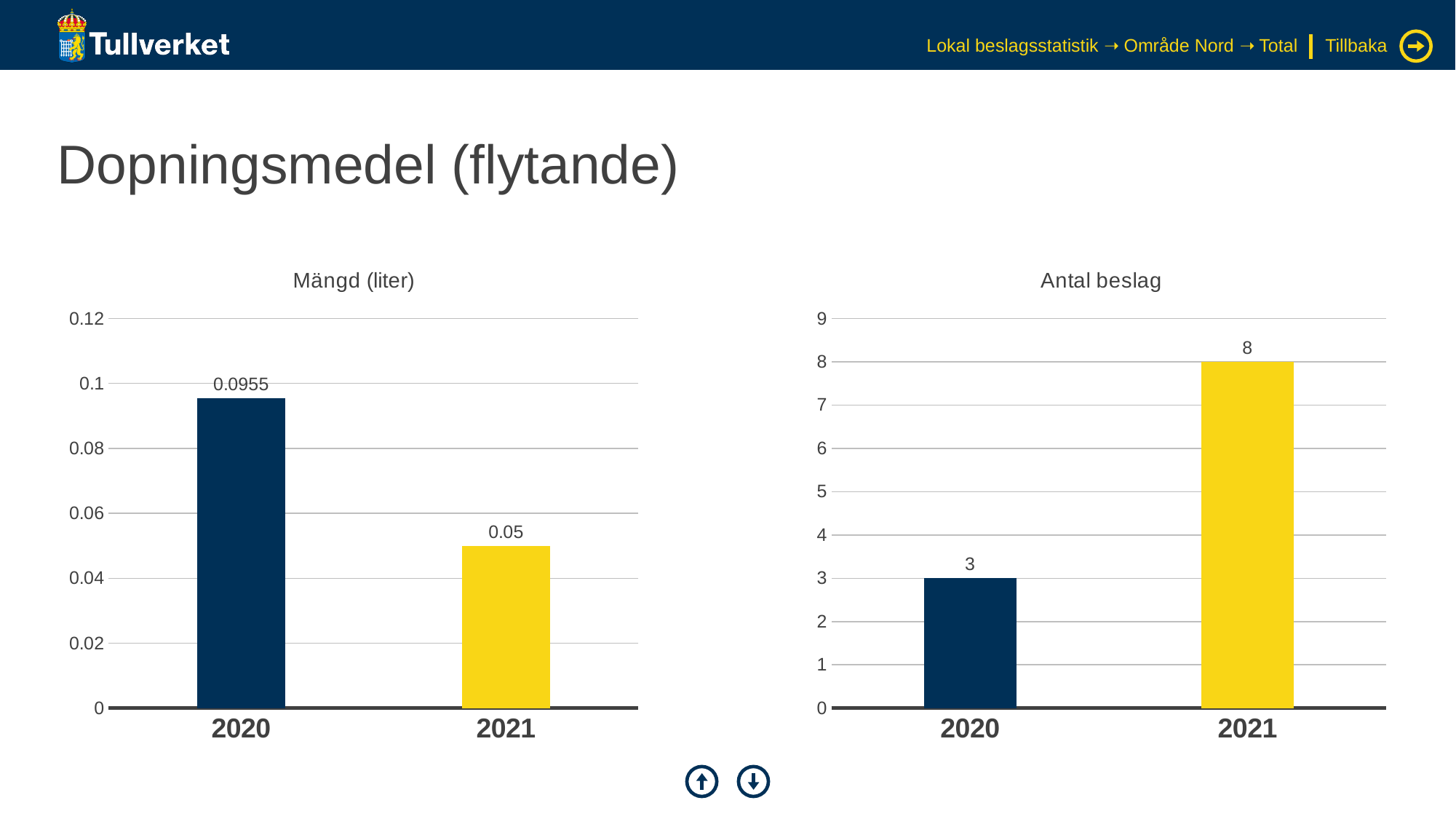
In the 'Antal beslag' chart, is the value for 2021 larger or smaller than the value for 2020? larger In the 'Antal beslag' chart, what is the difference between the values for 2021 and 2020? 5 In the 'Mängd (liter)' chart, what is the value for 2021? 0.05 In the 'Mängd (liter)' chart, what is the difference between the values for 2020 and 2021? 0.0455 In the 'Mängd (liter)' chart, which year has the highest value? 2020 In the 'Antal beslag' chart, what is the value for 2020? 3 In the 'Mängd (liter)' chart, how many years are shown on the x axis? 2 In the 'Mängd (liter)' chart, what is the value for 2020? 0.0955 In the 'Antal beslag' chart, which year has the lowest value? 2020 In the 'Antal beslag' chart, what is the value for 2021? 8 In the 'Mängd (liter)' chart, do the values rise or fall from 2020 to 2021? fall What type of chart is the 'Antal beslag' chart? bar chart